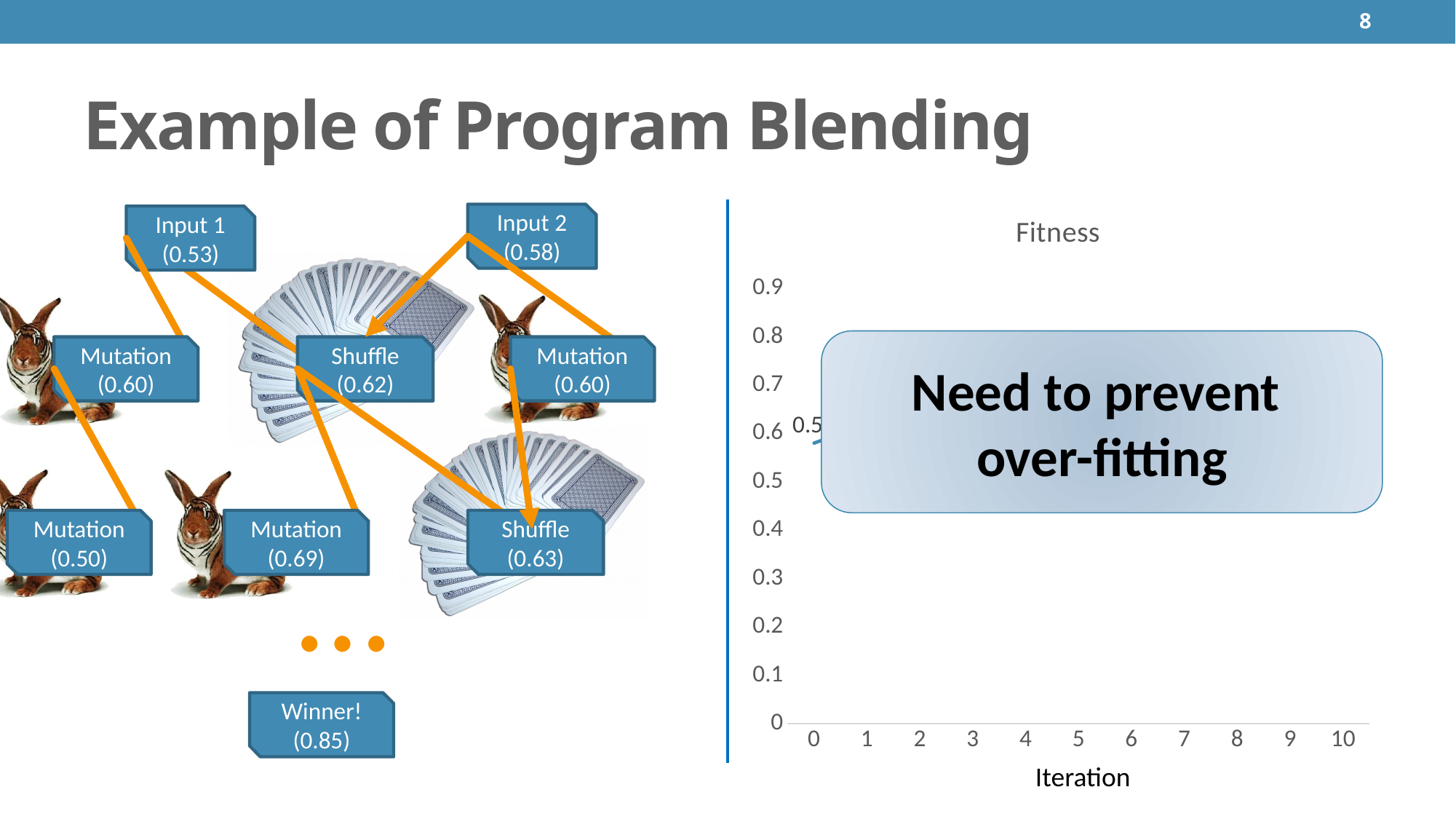
What kind of chart is the Fitness chart? line chart What is the label of the x axis of the Fitness chart? Iteration How many iteration ticks, from 0 to 10, are shown on the x axis of the Fitness chart? 11 In the Fitness chart, is the value at iteration 0 greater or less than 0.3? greater What is the title of the chart on the right side of the slide? Fitness In the Fitness chart, is the value at iteration 0 greater or less than 0.8? less